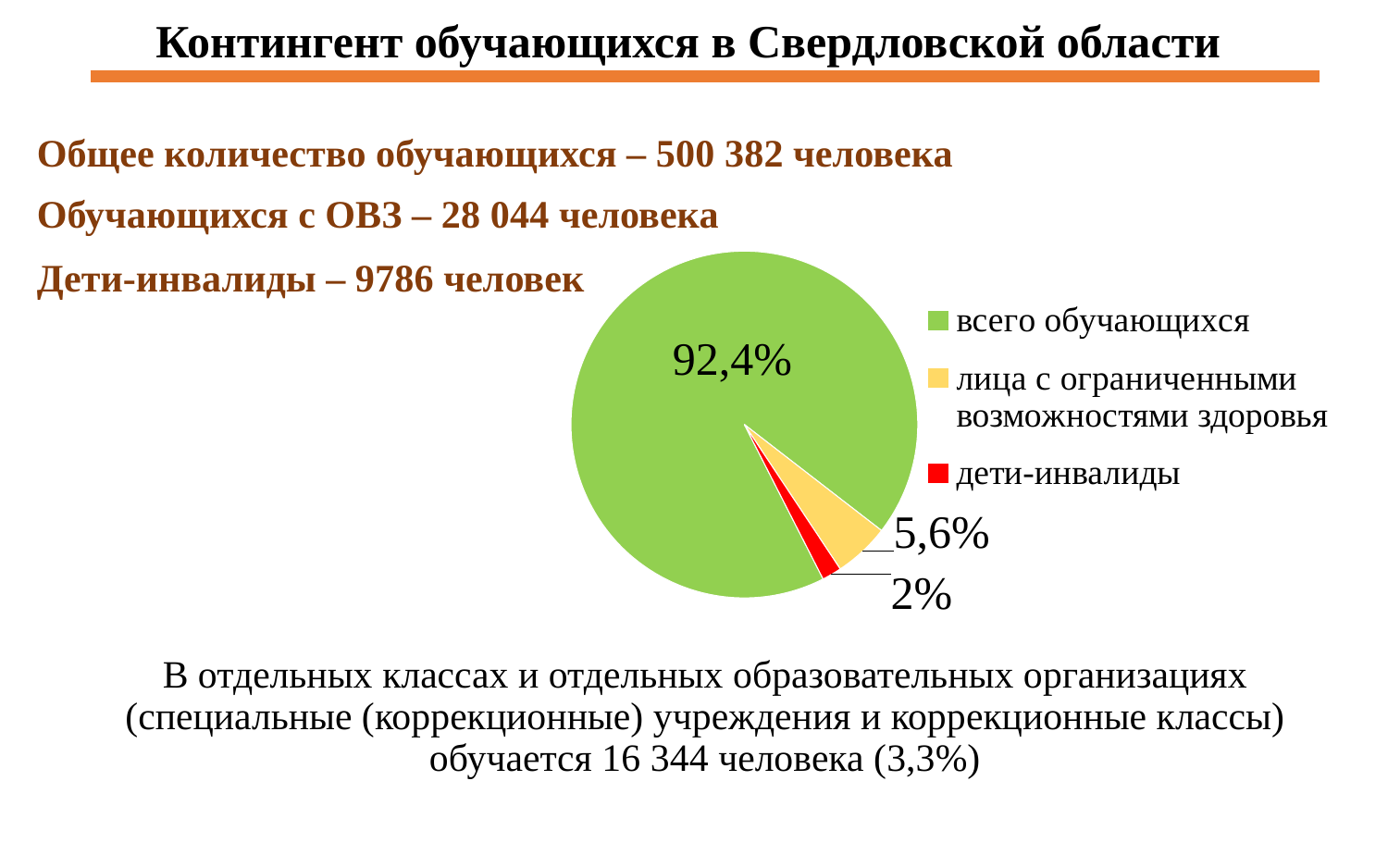
Which slice of the pie chart is the largest? всего обучающихся How many entries does the legend of the pie chart list? 3 What percentage is shown for the slice "всего обучающихся"? 92,4% What is the difference in percentage points between the slices "лица с ограниченными возможностями здоровья" and "дети-инвалиды"? 3,6 What colour is the slice for "дети-инвалиды" in the pie chart? red What percentage is shown for the slice "дети-инвалиды"? 2% What percentage is shown for the slice "лица с ограниченными возможностями здоровья"? 5,6% What kind of chart is shown on the slide? pie chart What colour is the slice for "всего обучающихся" in the pie chart? green Which slice of the pie chart is the smallest? дети-инвалиды How many slices does the pie chart have? 3 Which slice is larger: "лица с ограниченными возможностями здоровья" or "дети-инвалиды"? лица с ограниченными возможностями здоровья